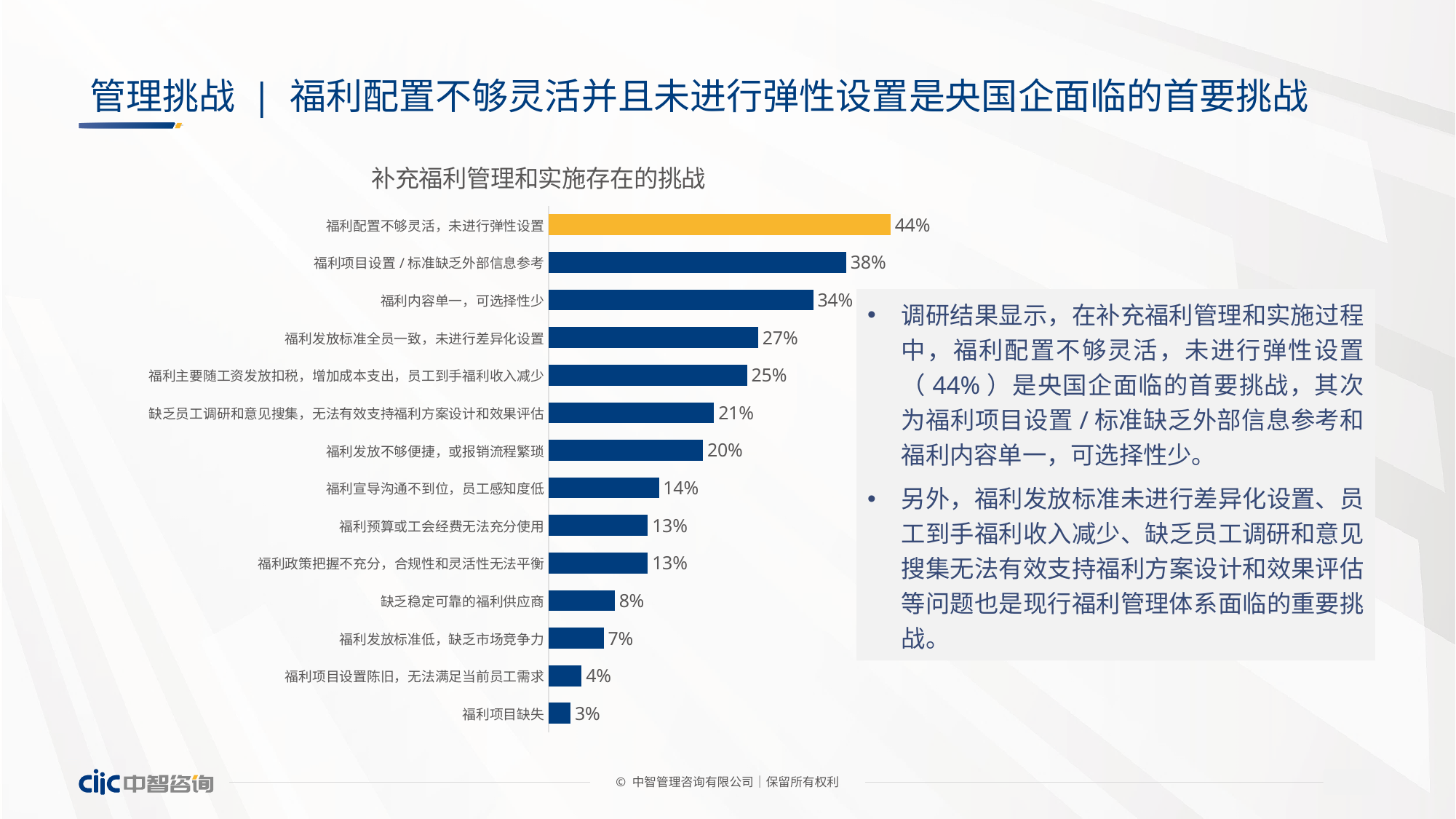
图表中占比最低的挑战是哪一项？ 福利项目缺失 图表中“福利内容单一，可选择性少”的占比是多少？ 34% 图表中共列出了多少项挑战？ 14 这是什么类型的图表？ 条形图 图表中占比最高的挑战是哪一项？ 福利配置不够灵活，未进行弹性设置 “福利发放标准低，缺乏市场竞争力”和“福利项目设置陈旧，无法满足当前员工需求”哪一项占比更高？ 福利发放标准低，缺乏市场竞争力 图表中“缺乏稳定可靠的福利供应商”的占比是多少？ 8% 图表的标题是什么？ 补充福利管理和实施存在的挑战 图表中“福利配置不够灵活，未进行弹性设置”的占比是多少？ 44% “福利发放不够便捷，或报销流程繁琐”与“福利宣导沟通不到位，员工感知度低”的占比相差多少个百分点？ 6个百分点 “福利发放标准全员一致，未进行差异化设置”和“福利主要随工资发放扣税，增加成本支出，员工到手福利收入减少”哪一项占比更高？ 福利发放标准全员一致，未进行差异化设置 “福利配置不够灵活，未进行弹性设置”与“福利项目设置 / 标准缺乏外部信息参考”的占比相差多少个百分点？ 6个百分点